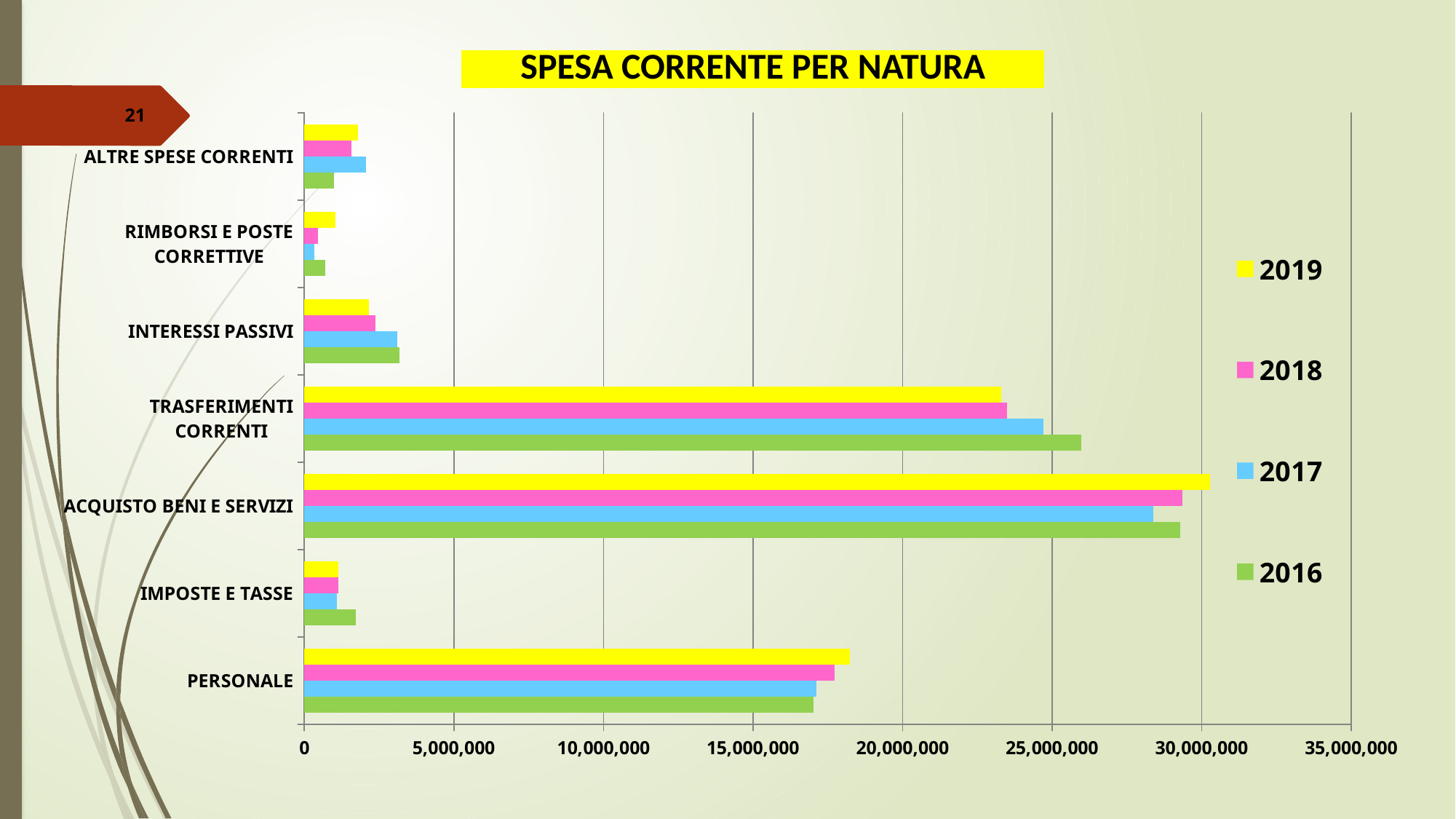
How many categories are shown on the chart? 7 Is the 2016 value for INTERESSI PASSIVI greater or less than 5,000,000? less Which category has the highest value in the chart? ACQUISTO BENI E SERVIZI What kind of chart is shown on the slide? bar chart How many series does the legend list? 4 What is the title of the chart? SPESA CORRENTE PER NATURA Is the 2019 value for PERSONALE greater or less than 20,000,000? less Which category has the lowest values in the chart? RIMBORSI E POSTE CORRETTIVE For ACQUISTO BENI E SERVIZI, which year has the larger value, 2019 or 2017? 2019 Is the 2016 value for TRASFERIMENTI CORRENTI greater or less than 25,000,000? greater Which colour represents the 2019 series in the legend? yellow For TRASFERIMENTI CORRENTI, which year has the larger value, 2016 or 2019? 2016